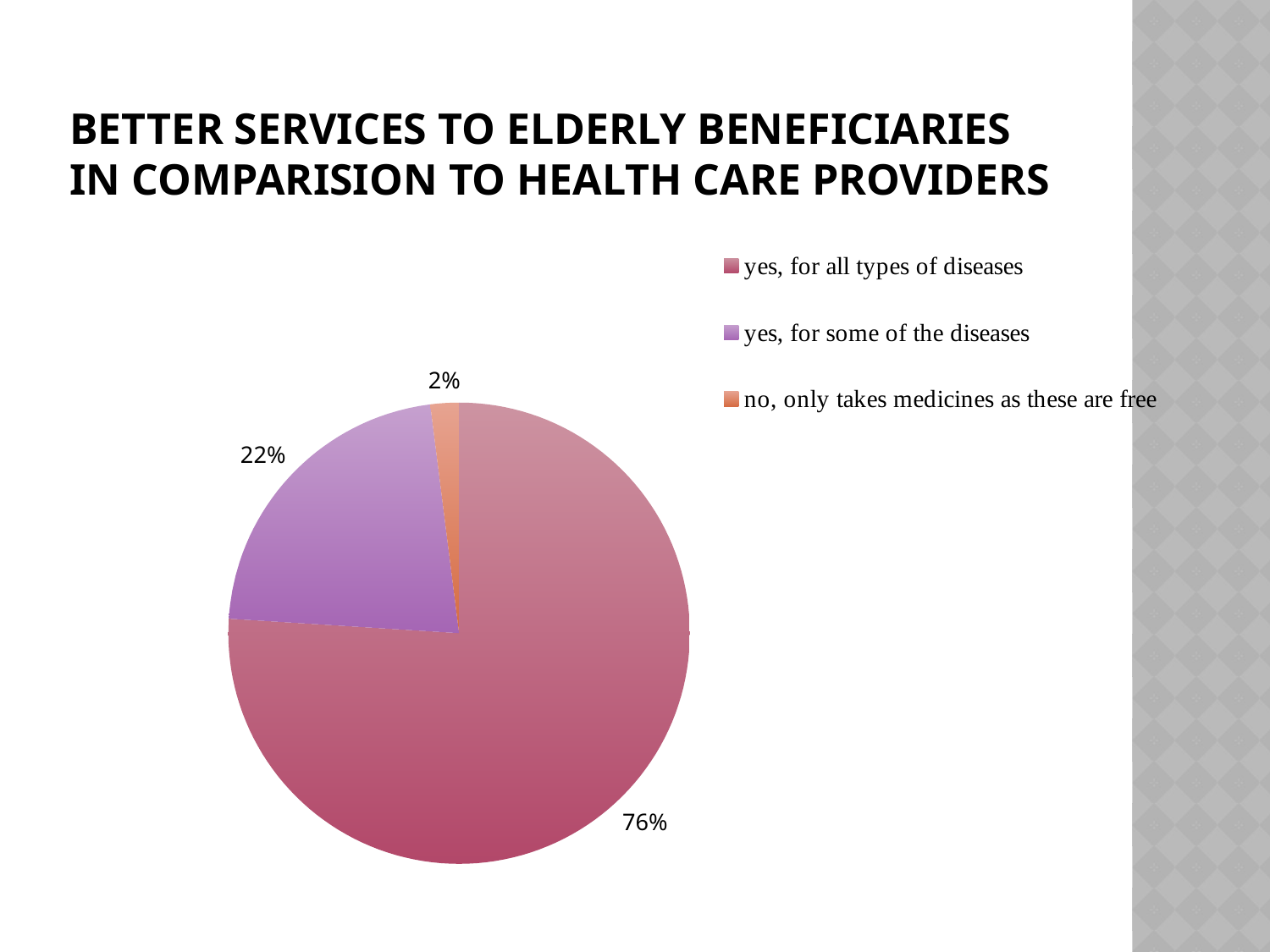
Which category has the largest slice of the pie? yes, for all types of diseases Which category has the smallest slice of the pie? no, only takes medicines as these are free What is the difference in percentage points between the "yes, for all types of diseases" slice and the "yes, for some of the diseases" slice? 54 What share of the pie is labelled "yes, for some of the diseases"? 22% Which is larger: the "yes, for some of the diseases" slice or the "no, only takes medicines as these are free" slice? yes, for some of the diseases How many categories does the pie chart show? 3 What colour is the slice for "yes, for some of the diseases"? purple What share of the pie is labelled "no, only takes medicines as these are free"? 2% What is the title of the slide containing the pie chart? BETTER SERVICES TO ELDERLY BENEFICIARIES IN COMPARISION TO HEALTH CARE PROVIDERS What kind of chart is shown on the slide? pie chart What share of the pie is labelled "yes, for all types of diseases"? 76% How many entries does the legend list? 3